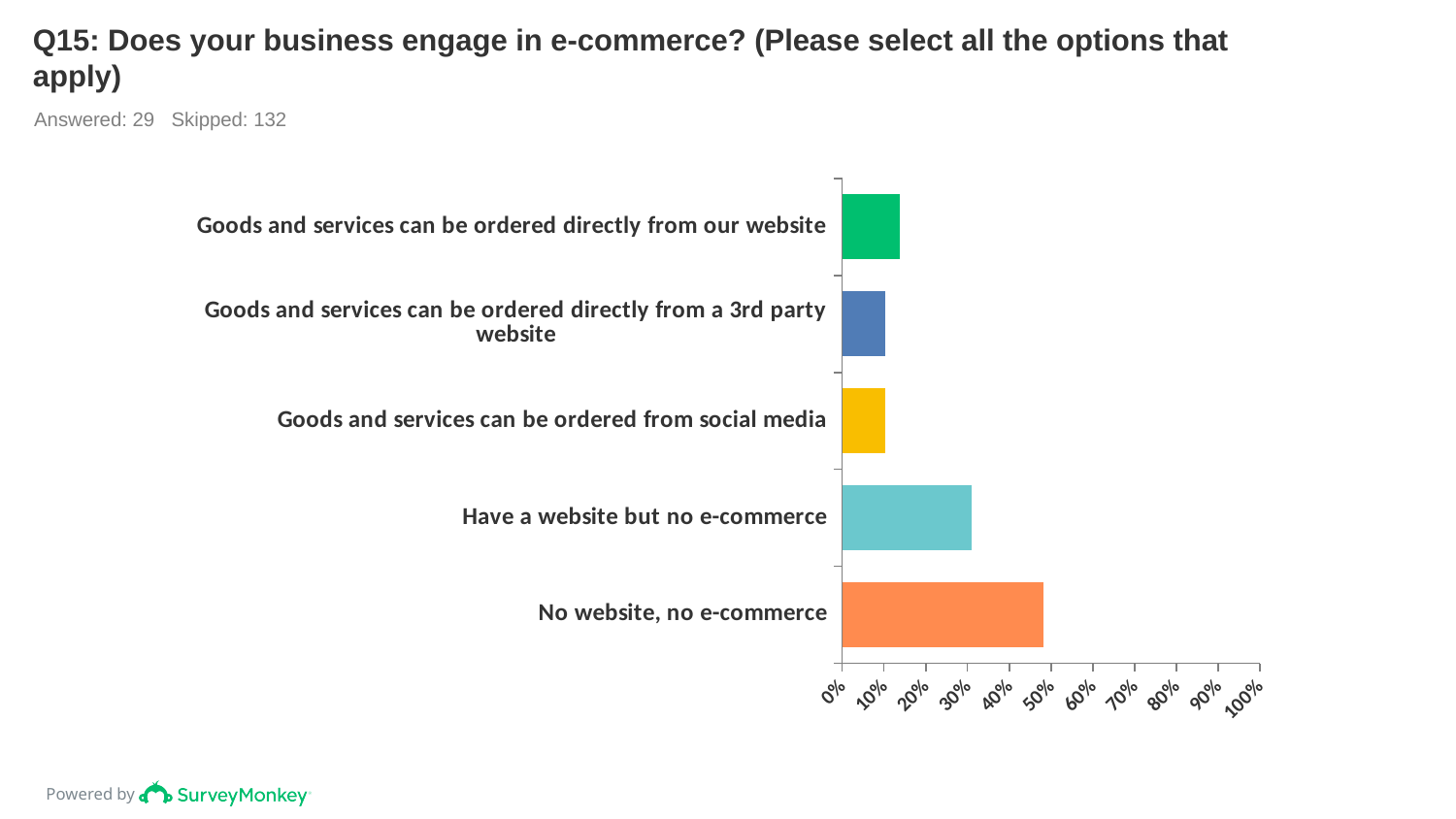
What colour is the bar for "No website, no e-commerce"? Orange How many categories are plotted in the chart? 5 Which category has the highest value? No website, no e-commerce What kind of chart is shown on the slide? Bar chart Is the value for "Have a website but no e-commerce" greater or less than 20%? greater What is the title of the chart? Q15: Does your business engage in e-commerce? (Please select all the options that apply) Is the value for "No website, no e-commerce" greater or less than 40%? greater Is the value for "Goods and services can be ordered from social media" greater or less than 20%? less Which is larger: the value for "No website, no e-commerce" or the value for "Have a website but no e-commerce"? No website, no e-commerce Which is larger: the value for "Have a website but no e-commerce" or the value for "Goods and services can be ordered directly from our website"? Have a website but no e-commerce